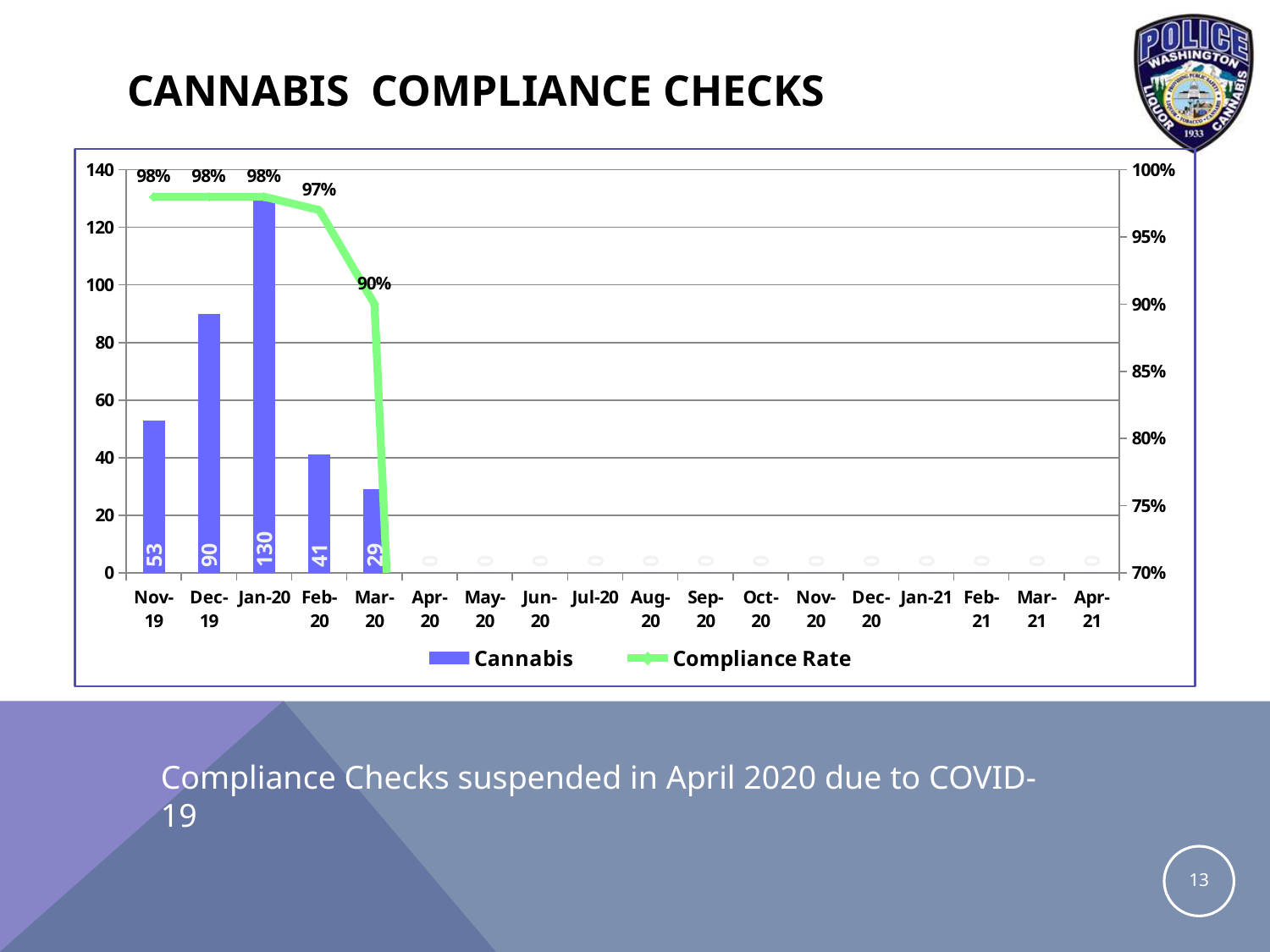
How many cannabis compliance checks were conducted in Nov-19? 53 What is the difference in cannabis compliance checks between Jan-20 and Dec-19? 40 What was the compliance rate in Mar-20? 90% Which month had the highest number of cannabis compliance checks? Jan-20 Which month with a plotted bar had the lowest number of cannabis compliance checks? Mar-20 What is the compliance rate in Feb-20? 97% How many series does the legend list? 2 What is the title of the chart? CANNABIS COMPLIANCE CHECKS Does the compliance rate rise or fall from Nov-19 to Mar-20? Fall What type of chart is used to show the Cannabis series? Bar chart How many cannabis compliance checks were conducted in Jan-20? 130 Which month had more cannabis compliance checks, Feb-20 or Mar-20? Feb-20